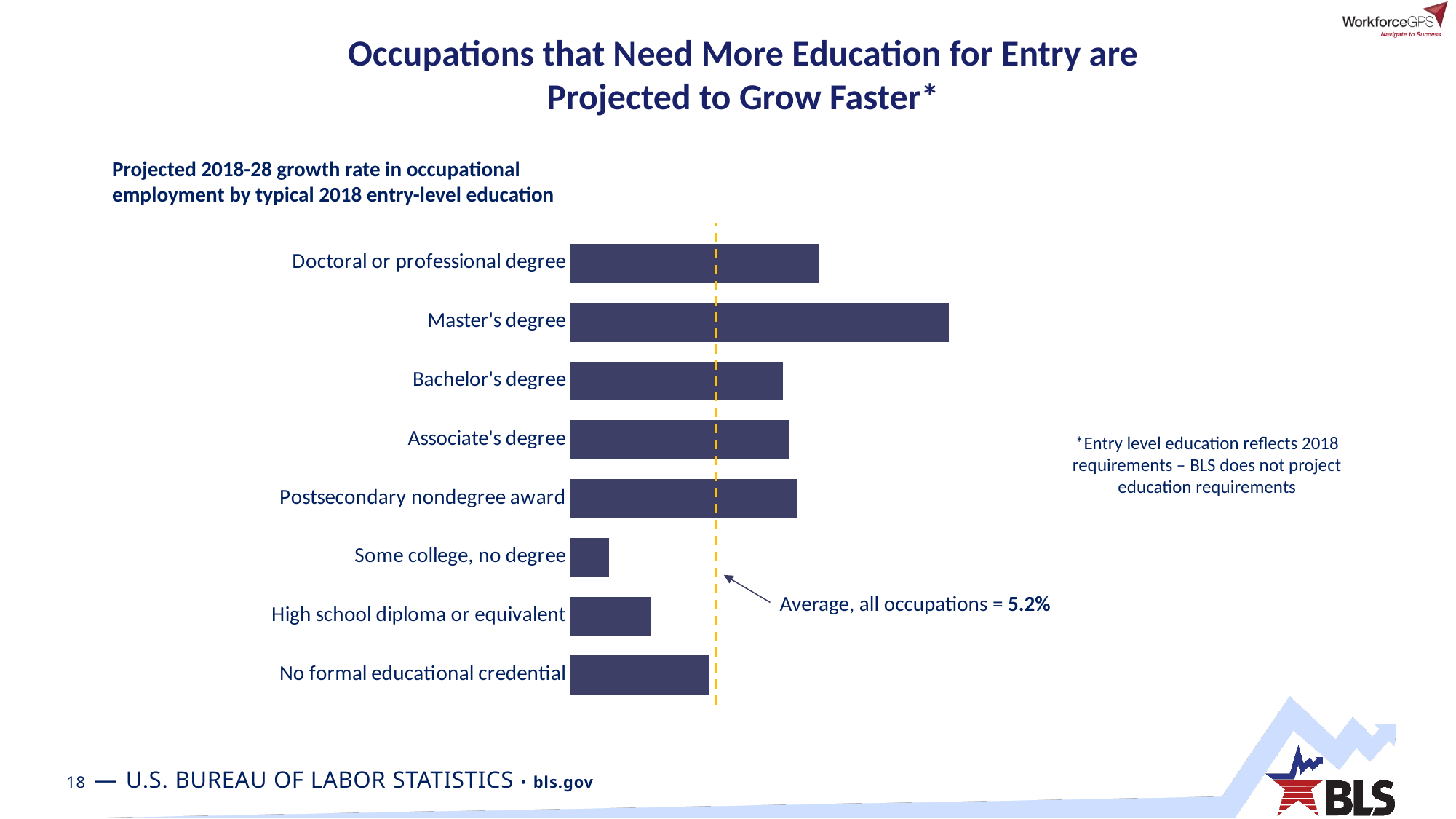
Which education category has the highest projected growth rate? Master's degree How many education categories are plotted in the chart? 8 Which has a higher projected growth rate, High school diploma or equivalent or Some college, no degree? High school diploma or equivalent Is the projected growth rate for Some college, no degree greater or less than the 5.2% average? less Which has a higher projected growth rate, No formal educational credential or High school diploma or equivalent? No formal educational credential What period does the projected growth rate in the chart cover? 2018-28 Which education category has the lowest projected growth rate? Some college, no degree Which has a higher projected growth rate, Master's degree or Doctoral or professional degree? Master's degree What kind of chart is shown on the slide? bar chart Is the projected growth rate for Bachelor's degree greater or less than the 5.2% average? greater What is the average projected growth rate for all occupations shown by the dashed line? 5.2%